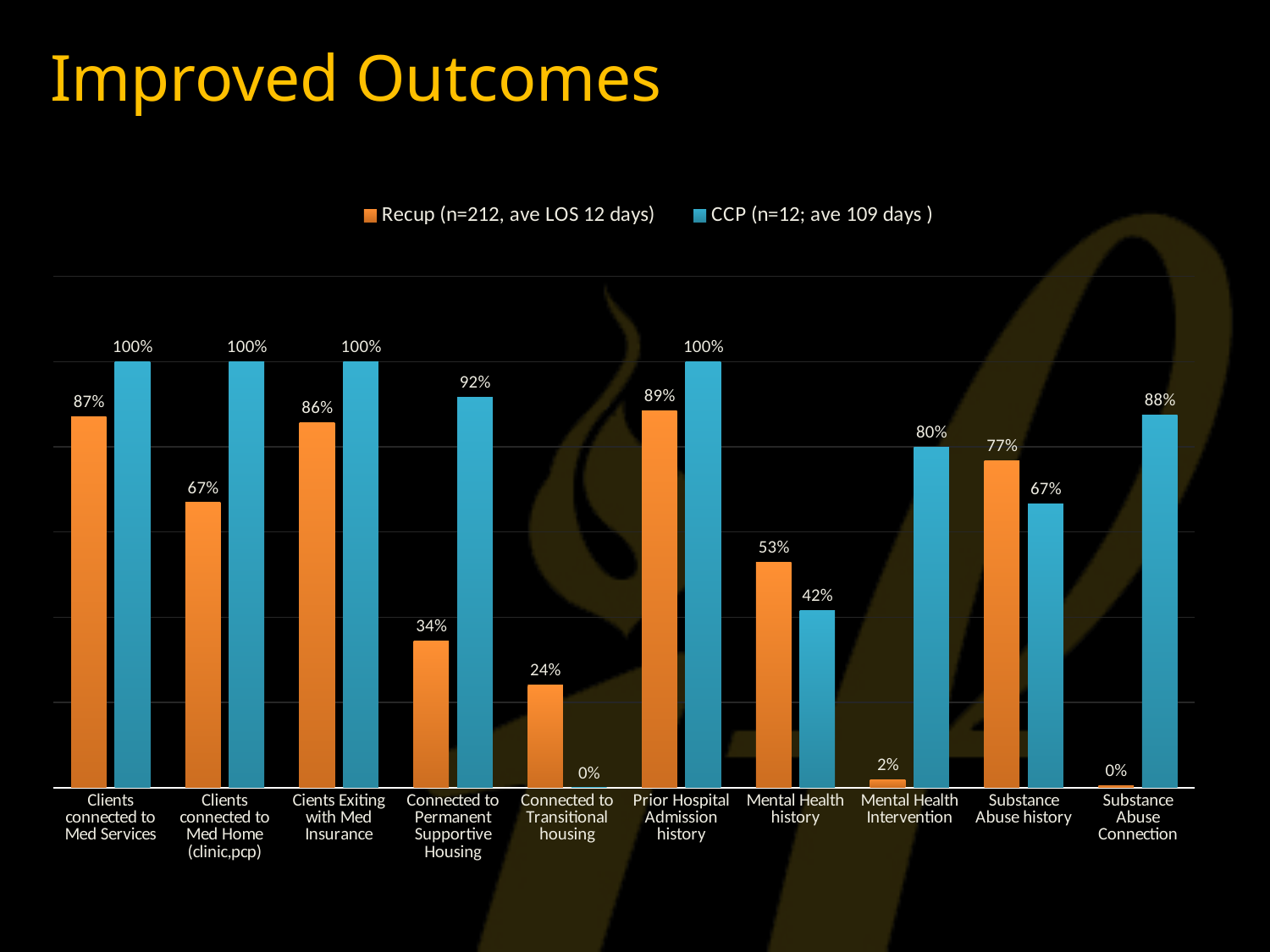
What is the Recup value for Connected to Permanent Supportive Housing? 34% Which category has the lowest Recup value? Substance Abuse Connection What is the difference between the CCP and Recup values for Connected to Permanent Supportive Housing? 58% What is the title of the slide? Improved Outcomes How many series does the legend list? 2 What kind of chart is shown on the slide? Bar chart For Mental Health history, which series has the larger value, Recup or CCP? Recup What is the CCP value for Connected to Transitional housing? 0% How many categories are shown on the x axis? 10 What is the Recup value for Substance Abuse history? 77% What is the CCP value for Mental Health Intervention? 80% Which category has the highest Recup value? Prior Hospital Admission history